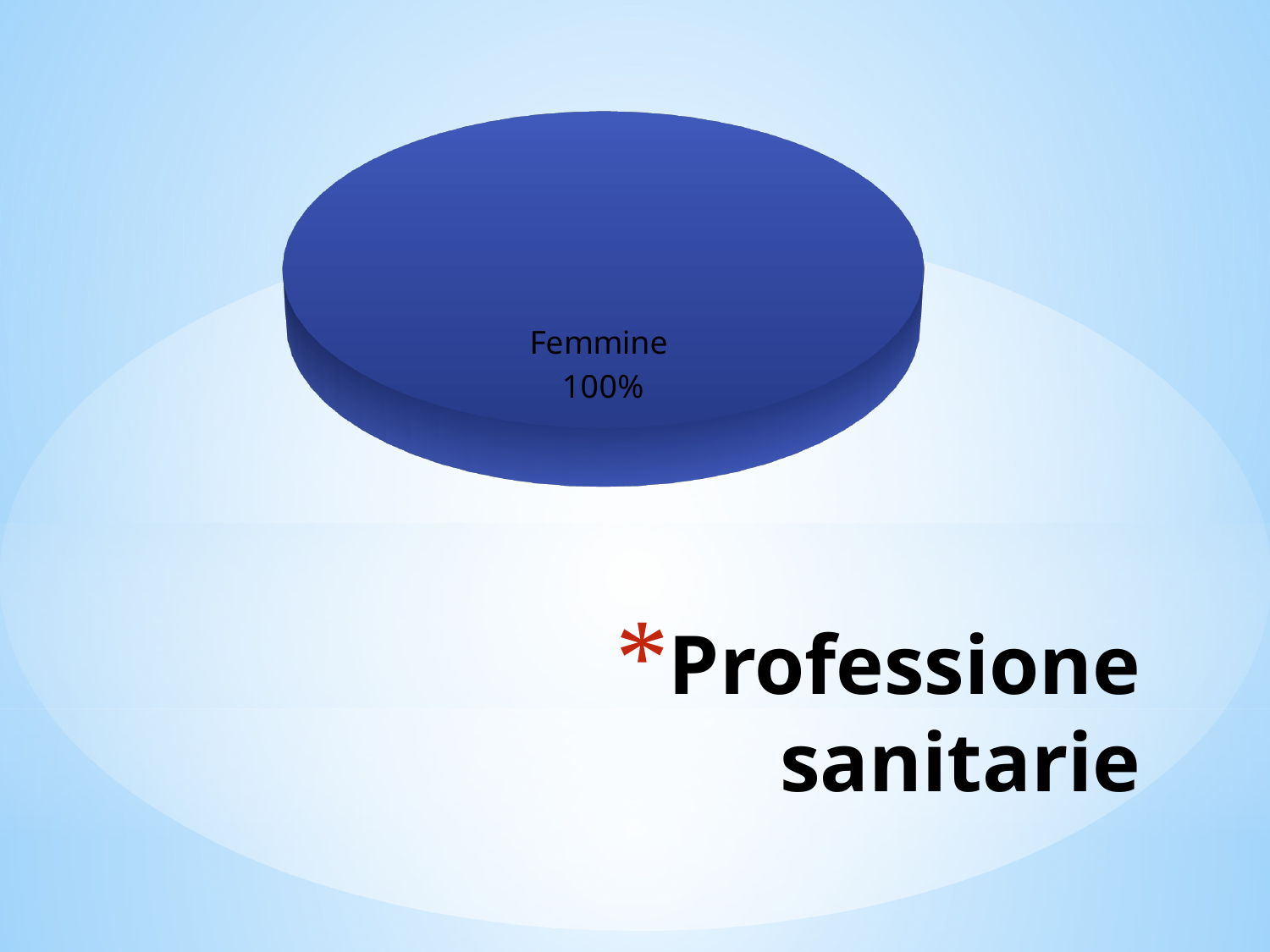
What share of the pie does the Femmine slice represent? 100% Which category is labelled on the pie chart? Femmine What kind of chart is shown on the slide? Pie chart What colour is the Femmine slice of the pie chart? Blue How many slices does the pie chart have? 1 Is the value for Femmine greater or less than 50%? greater What is the value shown for Femmine in the pie chart? 100%